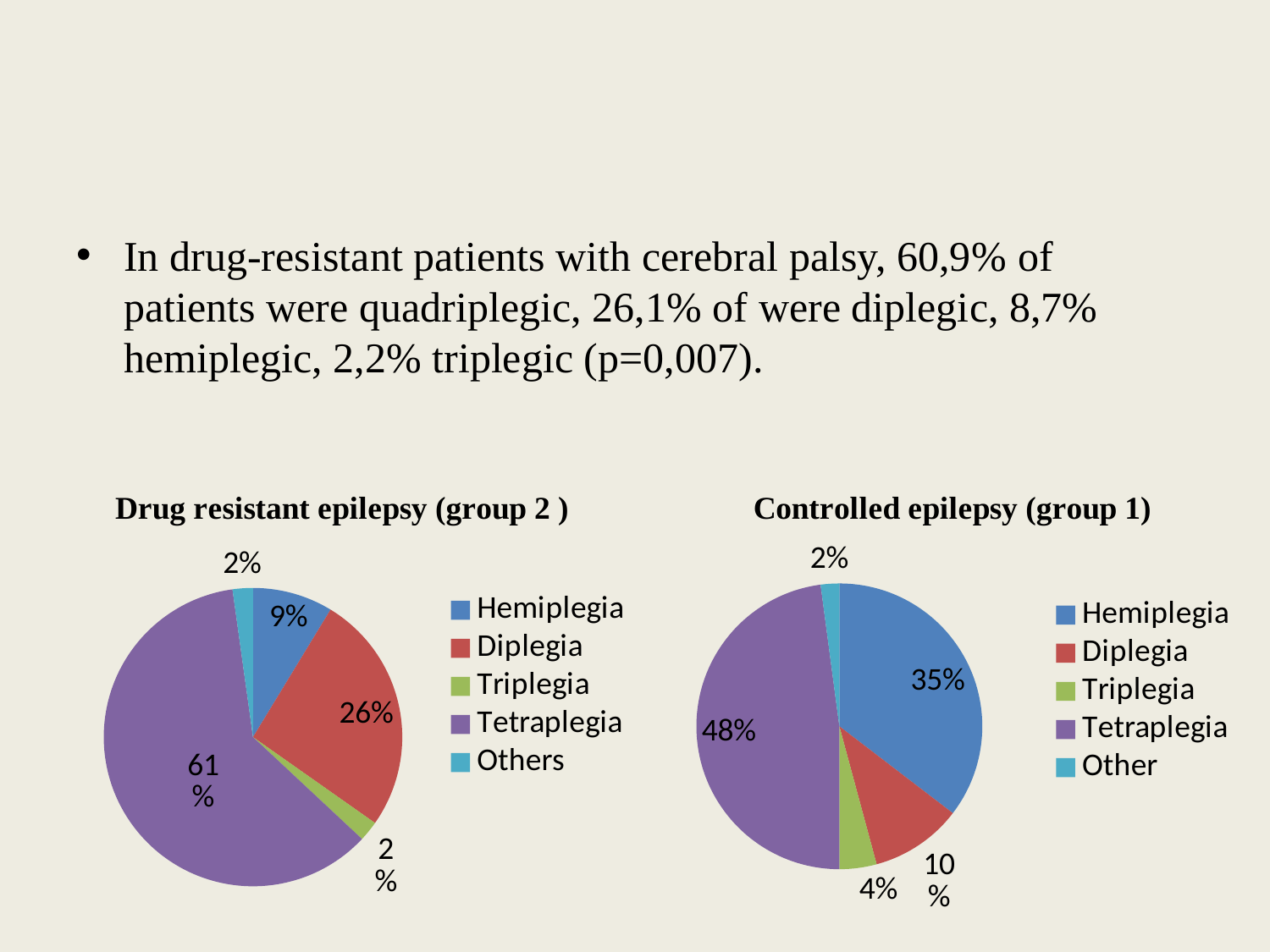
In the 'Drug resistant epilepsy (group 2 )' chart, which category has the largest slice? Tetraplegia What type of chart is the 'Drug resistant epilepsy (group 2 )' chart? Pie chart In the 'Controlled epilepsy (group 1)' chart, what percentage is shown for Hemiplegia? 35% In the 'Drug resistant epilepsy (group 2 )' chart, what percentage is shown for Diplegia? 26% Which is larger: Hemiplegia in the 'Drug resistant epilepsy (group 2 )' chart or Hemiplegia in the 'Controlled epilepsy (group 1)' chart? Controlled epilepsy (group 1) In the 'Controlled epilepsy (group 1)' chart, what percentage is shown for Triplegia? 4% How many categories does the legend of the 'Controlled epilepsy (group 1)' chart list? 5 In the 'Controlled epilepsy (group 1)' chart, which category has the smallest slice? Other In the 'Controlled epilepsy (group 1)' chart, which category has the largest slice? Tetraplegia In the 'Drug resistant epilepsy (group 2 )' chart, what is the difference between the Tetraplegia and Diplegia percentages? 35% In the 'Controlled epilepsy (group 1)' chart, what is the difference between the Hemiplegia and Diplegia percentages? 25% In the 'Drug resistant epilepsy (group 2 )' chart, what percentage is shown for Tetraplegia? 61%